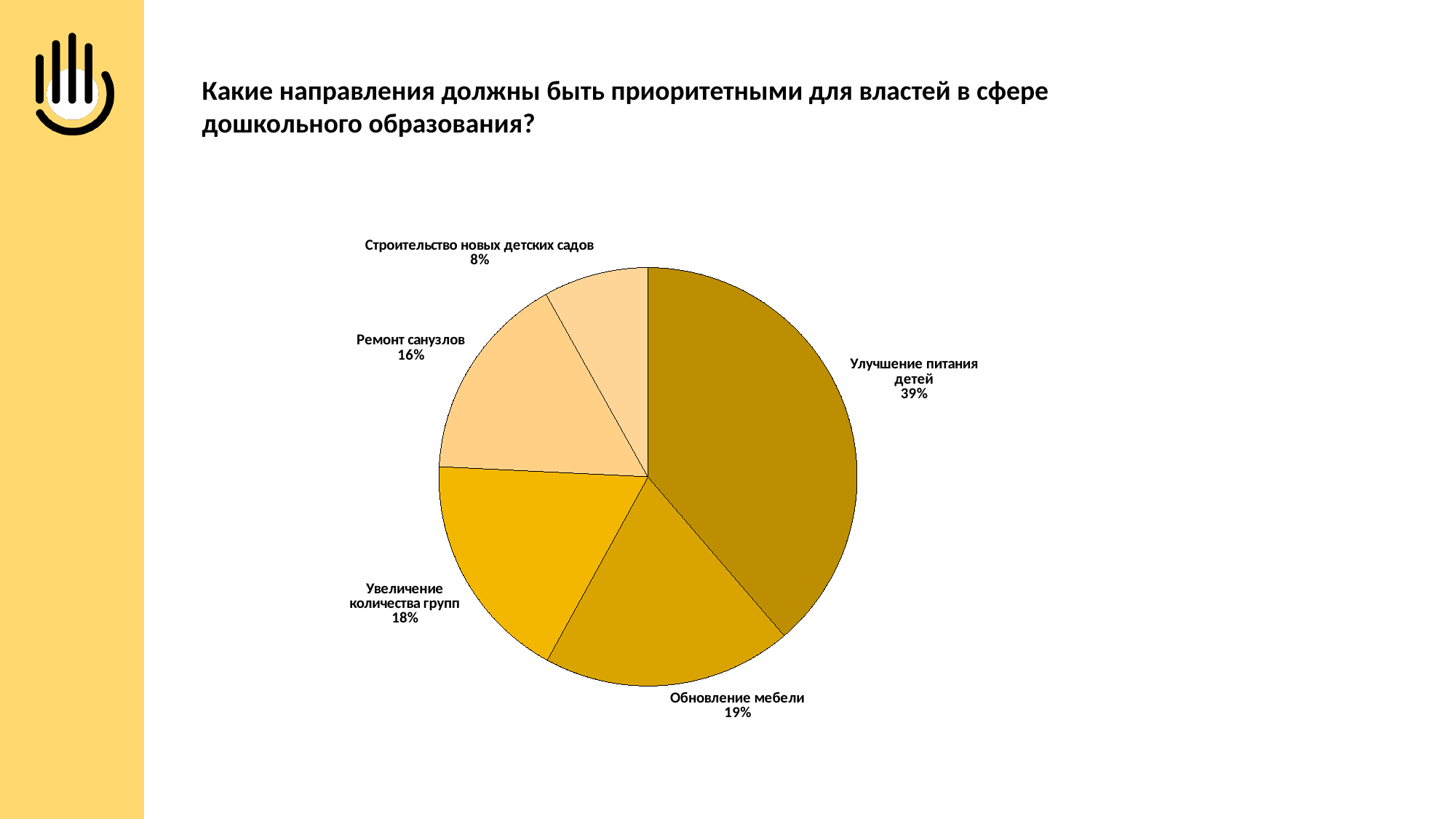
What is the difference in percentage points between "Ремонт санузлов" and "Строительство новых детских садов"? 8 Which category has the largest slice of the pie? Улучшение питания детей What share of the pie is labelled "Обновление мебели"? 19% How many categories are shown in the pie chart? 5 Which category has the smallest slice of the pie? Строительство новых детских садов Which is larger: the share for "Ремонт санузлов" or the share for "Увеличение количества групп"? Увеличение количества групп What kind of chart is shown on the slide? Pie chart What share of the pie is labelled "Строительство новых детских садов"? 8% What share of the pie is labelled "Ремонт санузлов"? 16% What is the difference in percentage points between "Улучшение питания детей" and "Обновление мебели"? 20